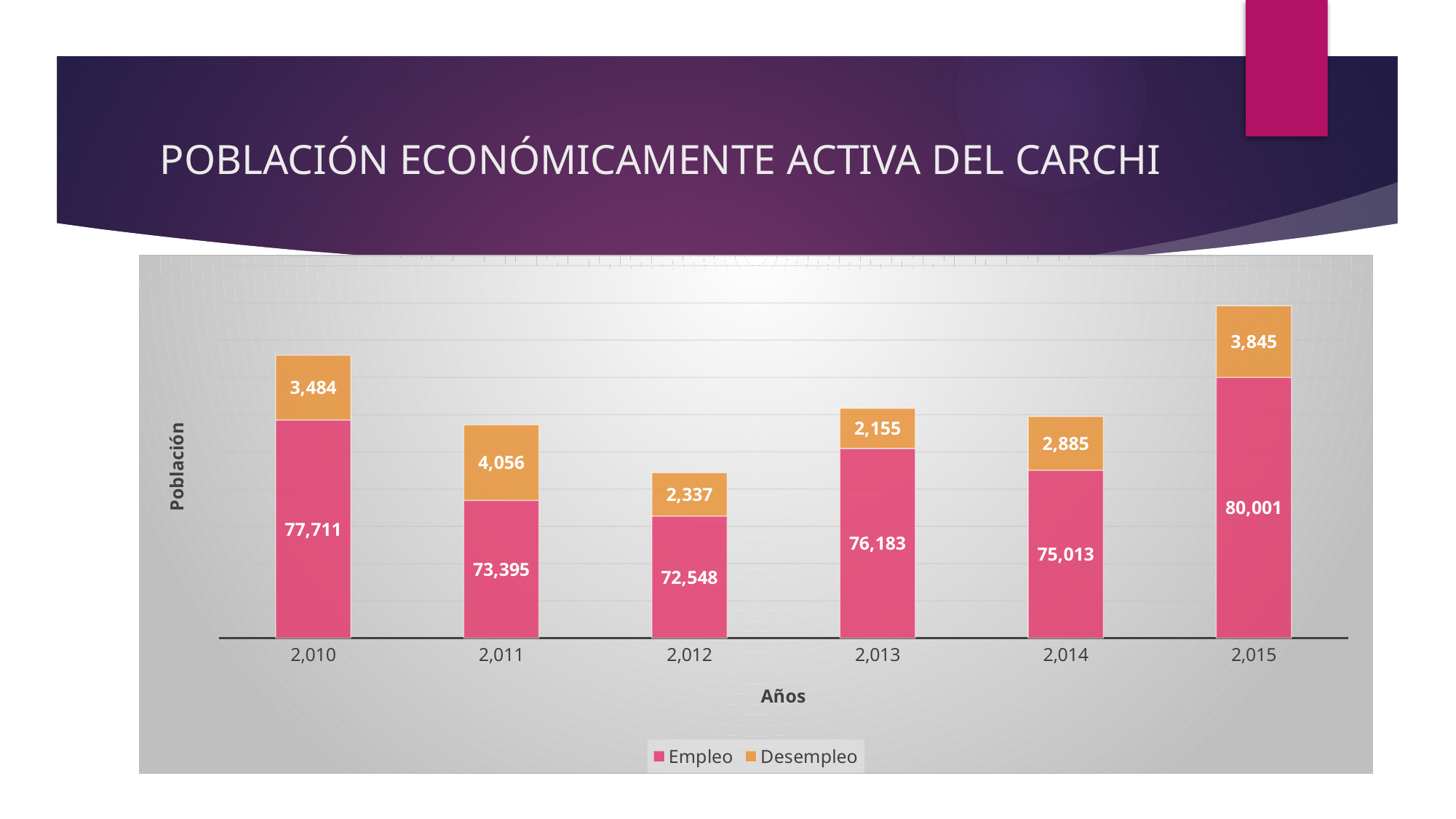
How many series does the legend list? 2 What is the Empleo value for 2,010? 77,711 Which is larger, the Desempleo value for 2,014 or for 2,012? 2,014 What is the total of the stacked bar for 2,015? 83,846 Which year has the highest Desempleo value? 2,011 Which year has the lowest Empleo value? 2,012 What is the difference between the Empleo values for 2,015 and 2,010? 2,290 What is the Desempleo value for 2,013? 2,155 What is the label of the y axis? Población What kind of chart is shown on the slide? Stacked bar chart How many years are shown on the x axis? 6 What is the Empleo value for 2,015? 80,001